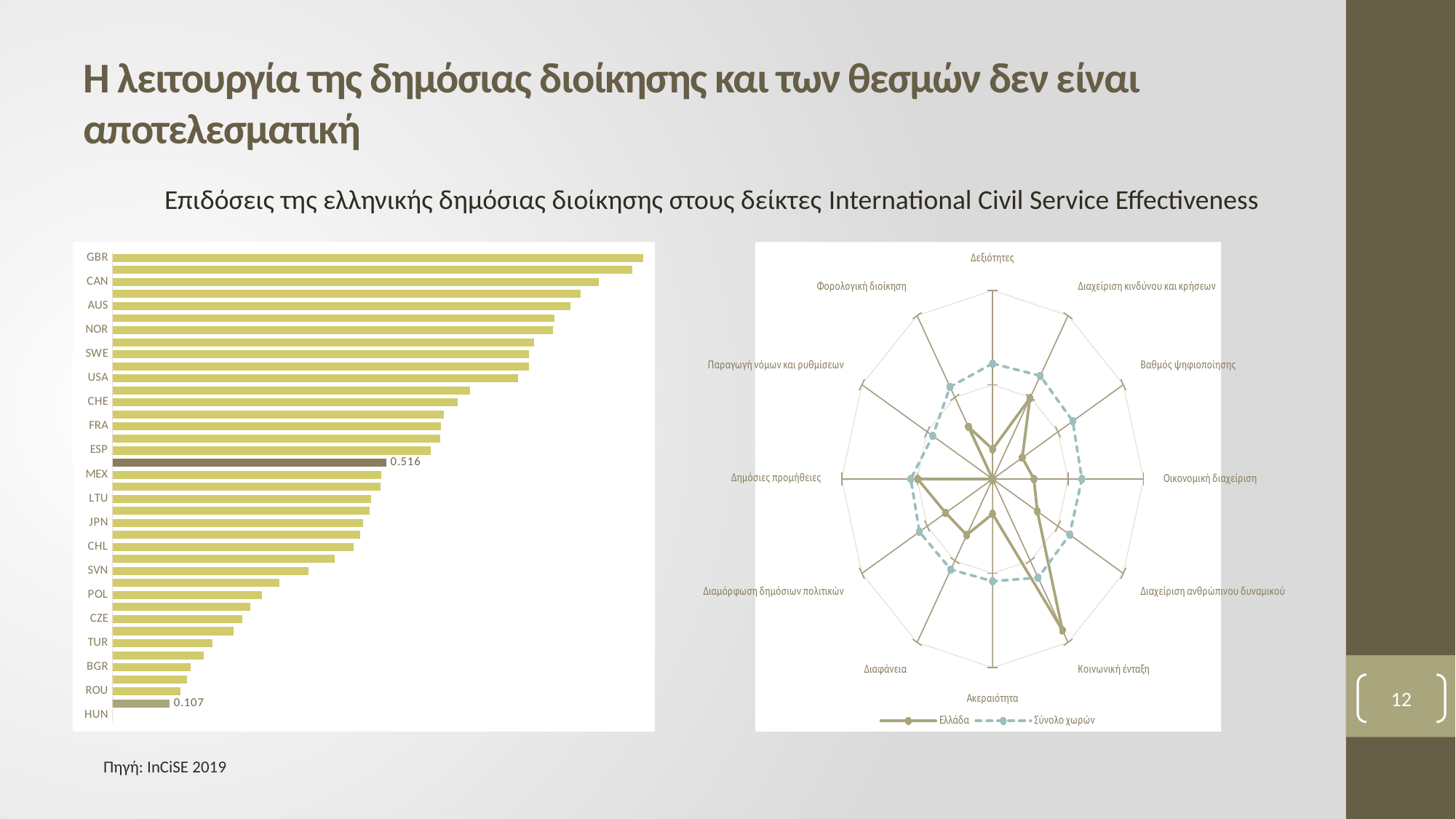
In the left bar chart, what value is labelled on the dark highlighted bar? 0.516 How many categories (axes) does the right-hand radar chart have? 12 In the right-hand radar chart, on which category does the Ελλάδα series reach its highest value? Κοινωνική ένταξη In the left bar chart, which is larger, the value for TUR or the value for SWE? SWE How many series does the legend of the right-hand radar chart list? 2 What kind of chart is the chart on the left of the slide? bar chart In the left bar chart, which is larger, the value for CAN or the value for POL? CAN In the left bar chart, which country has the highest value? GBR What kind of chart is the chart on the right of the slide? radar chart In the left bar chart, which country has the lowest value? HUN